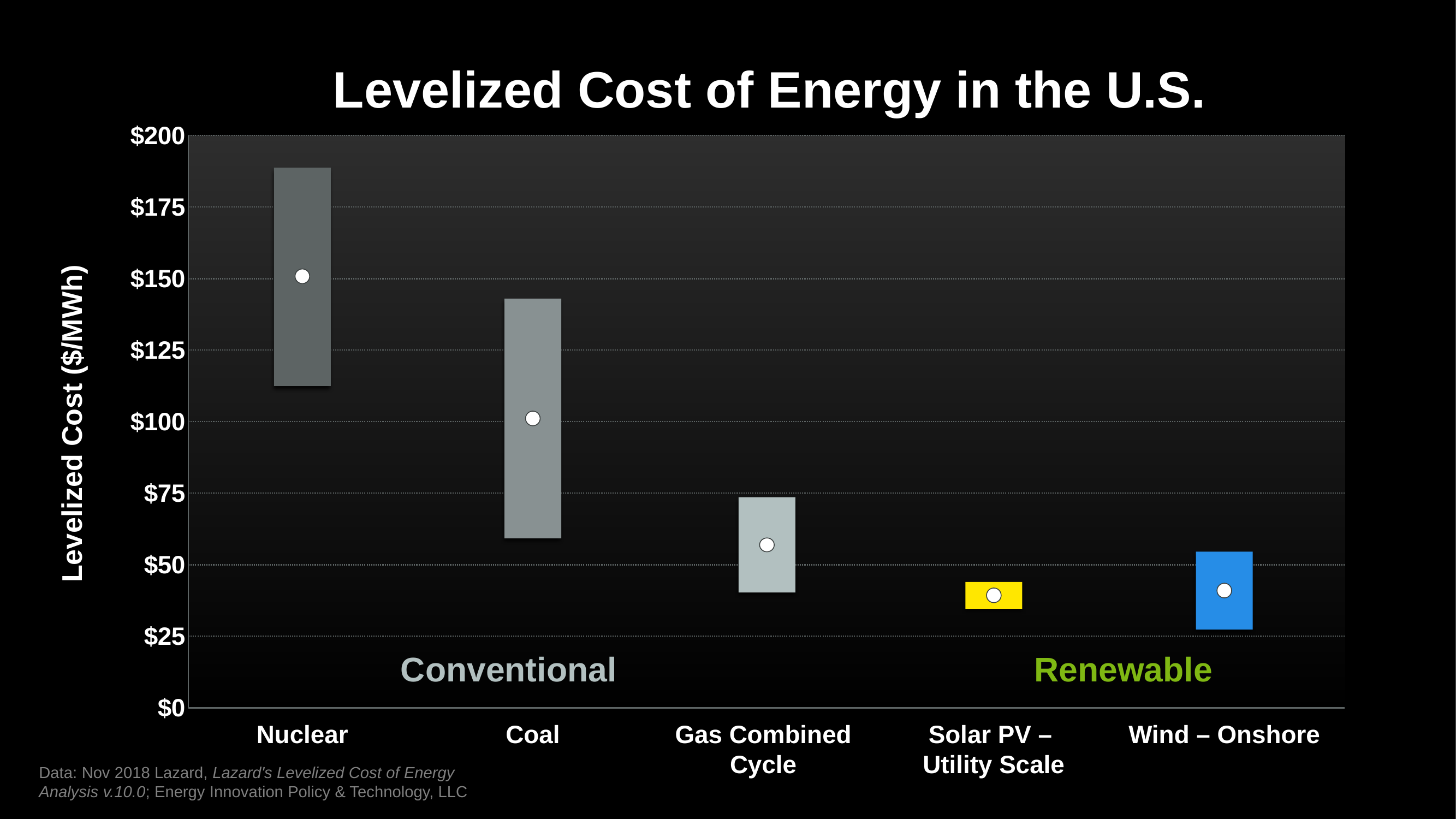
What kind of chart is this? Bar chart Is the bottom of the Nuclear range greater or less than $100? greater Which has the larger midpoint value, Coal or Gas Combined Cycle? Coal Which category's range reaches the lowest top value? Solar PV – Utility Scale Is the midpoint value for Gas Combined Cycle greater or less than $75? less Do the midpoint values rise or fall from Nuclear to Gas Combined Cycle along the x axis? fall How many energy categories are shown on the x axis? 5 What is the title of the chart? Levelized Cost of Energy in the U.S. What is the label on the vertical axis? Levelized Cost ($/MWh) Is the midpoint value for Nuclear greater or less than $125? greater Which category has the highest midpoint value? Nuclear